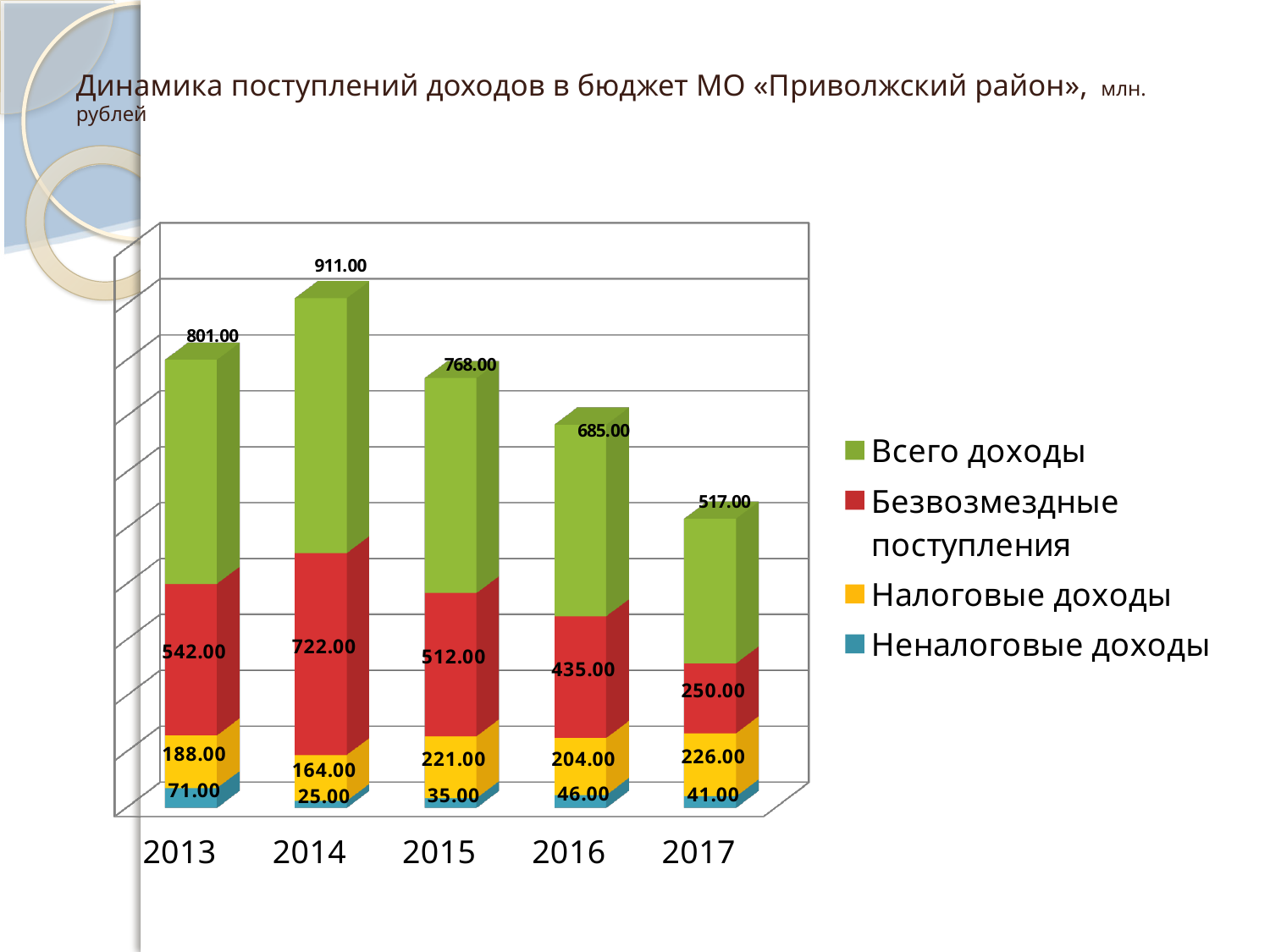
What is the value of Безвозмездные поступления for 2016? 435.00 What is the value of Налоговые доходы for 2017? 226.00 What is the difference between Всего доходы in 2013 and in 2017? 284.00 How many series does the legend list? 4 What is the value of Неналоговые доходы for 2013? 71.00 Does Всего доходы rise or fall from 2014 to 2017? Fall In which year is Всего доходы the highest? 2014 In which year is Неналоговые доходы the lowest? 2014 Which is larger: Налоговые доходы in 2015 or in 2016? 2015 How many years are shown on the x axis? 5 What is the value of Всего доходы for 2014? 911.00 What kind of chart is shown on the slide? Stacked bar chart